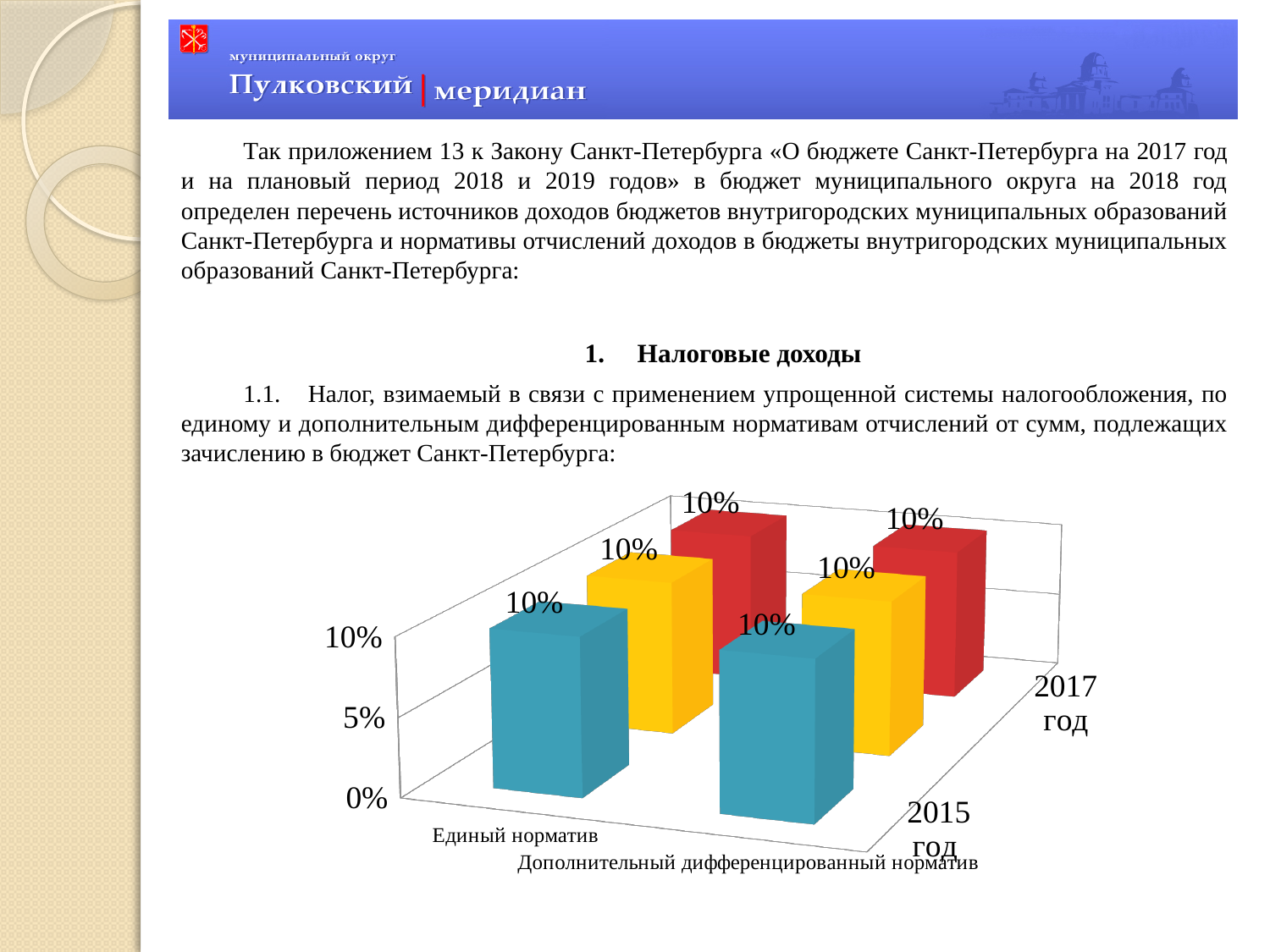
What is the value of the blue bar for "Дополнительный дифференцированный норматив"? 10% What is the value of the yellow bar for "Единый норматив"? 10% Is the value of the red bar for "Единый норматив" greater or less than 5%? greater What is the value of the blue bar for "Единый норматив"? 10% What kind of chart is shown on the slide? bar chart How many categories are shown along the horizontal axis of the chart? 2 Which years are labelled on the depth axis of the chart? 2015 год and 2017 год What is the value of the red bar for "Дополнительный дифференцированный норматив"? 10% Do the values change between "Единый норматив" and "Дополнительный дифференцированный норматив" for the yellow bars? No, both are 10% How many bars are plotted in the chart in total? 6 What is the highest tick value shown on the vertical axis of the chart? 10% What is the difference between the blue bar and the red bar for "Единый норматив"? 0%